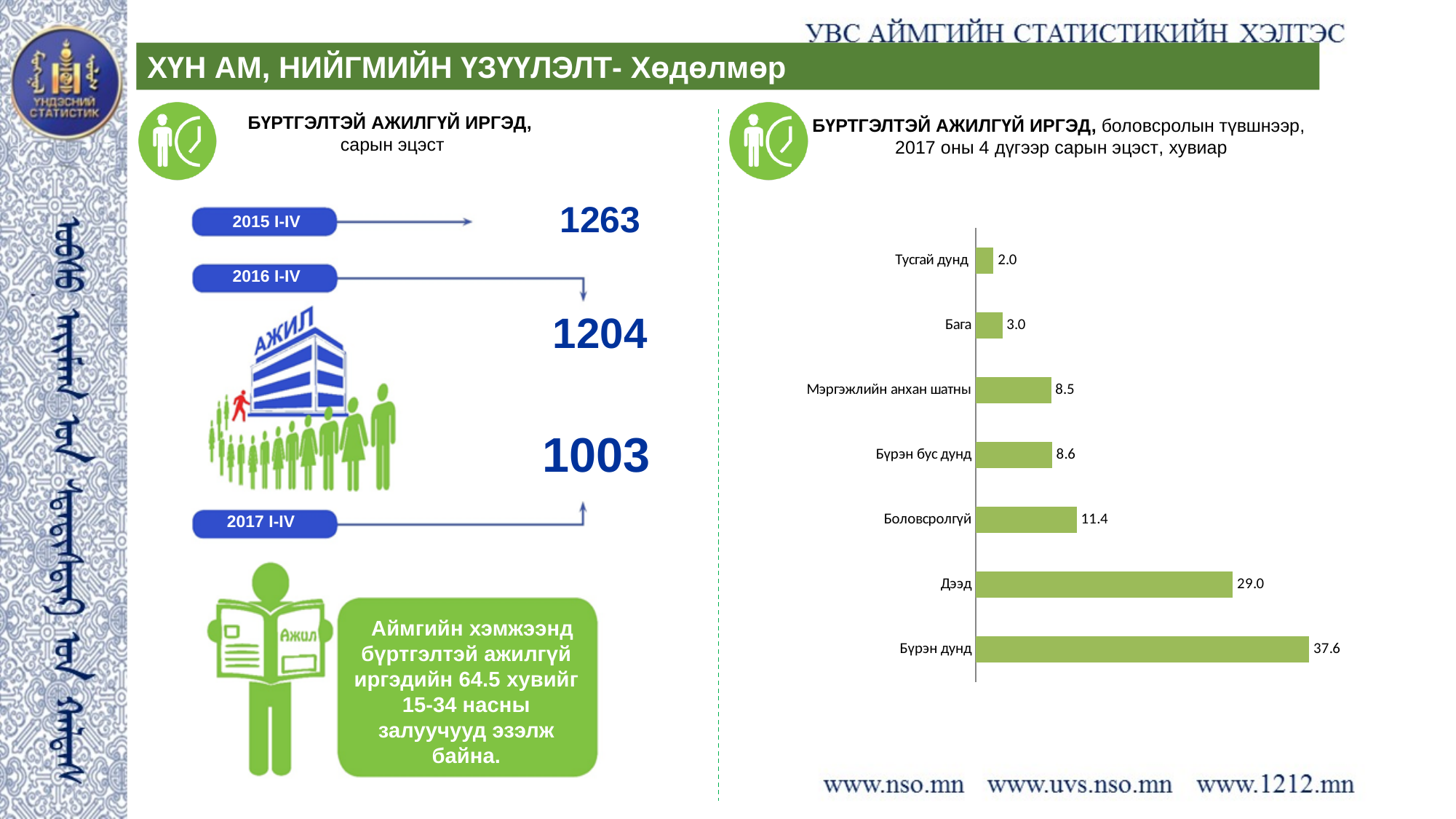
In the bar chart on the right, what is the value for Бүрэн дунд? 37.6 In the bar chart on the right, what is the value for Бага? 3.0 What colour are the bars in the chart on the right side of the slide? Green In the bar chart on the right, which category has the highest value? Бүрэн дунд How many categories are shown in the bar chart on the right? 7 In the bar chart on the right, what is the value for Дээд? 29.0 In the bar chart on the right, what is the value for Боловсролгүй? 11.4 What kind of chart is shown on the right side of the slide? Bar chart In the bar chart on the right, which is larger: the value for Дээд or the value for Боловсролгүй? Дээд In the bar chart on the right, what is the difference between the values for Бүрэн дунд and Дээд? 8.6 In the bar chart on the right, what is the difference between the values for Боловсролгүй and Бага? 8.4 In the bar chart on the right, which category has the lowest value? Тусгай дунд